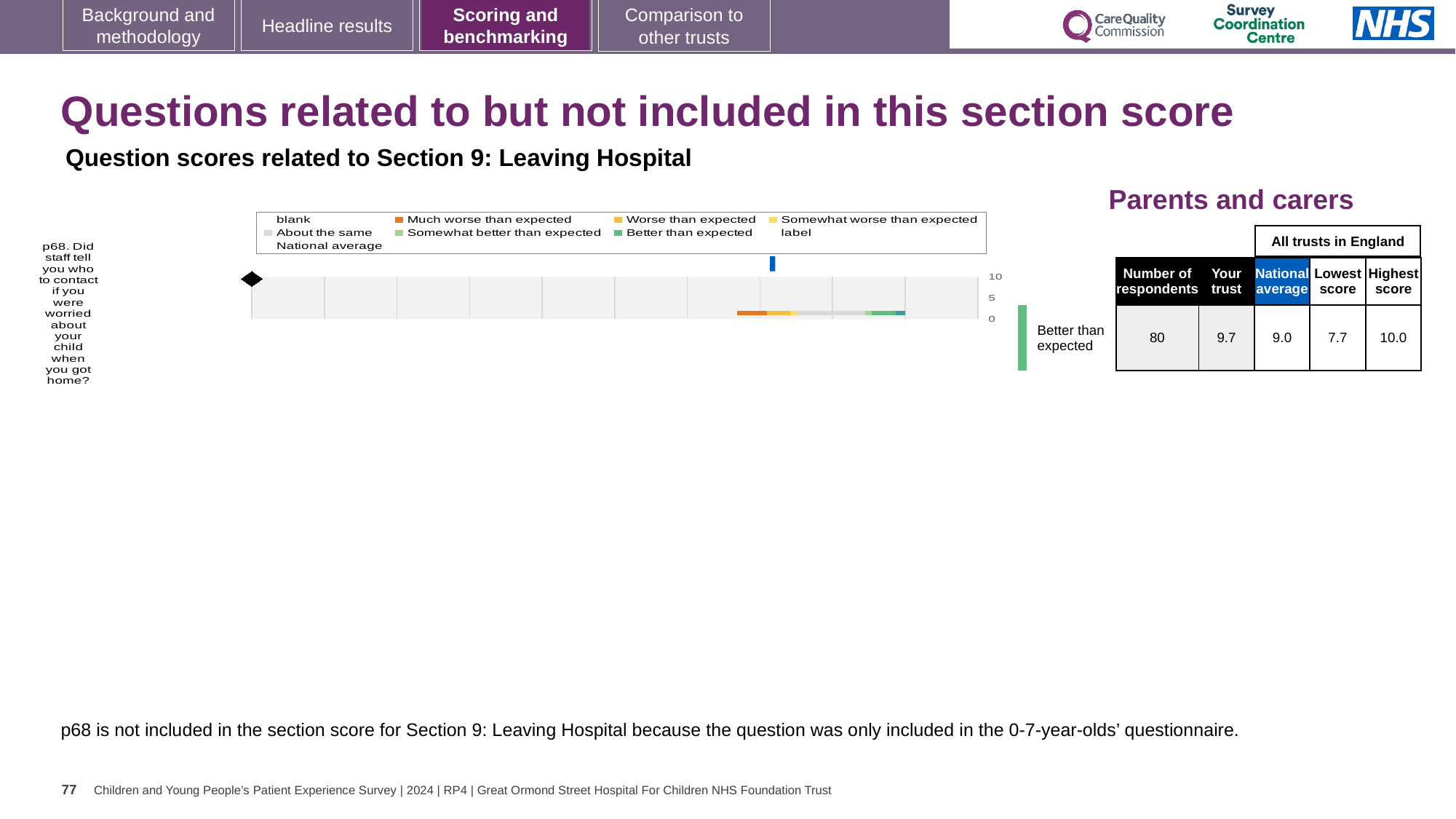
Which question is plotted in the chart? p68. Did staff tell you who to contact if you were worried about your child when you got home? Is the trust's score for p68 higher or lower than the national average? higher According to the table beside the chart, what is the lowest score among all trusts in England for p68? 7.7 According to the table beside the chart, what is the highest score among all trusts in England for p68? 10.0 According to the table beside the chart, how many respondents answered p68? 80 What kind of chart is shown on the slide? bar chart According to the table beside the chart, what is the national average score for p68? 9.0 How many survey questions are plotted in the chart? 1 What rating label is shown next to the chart for question p68? Better than expected According to the table beside the chart, what is the 'Your trust' score for p68? 9.7 What is the highest tick value shown on the chart's axis? 10 What is the difference between the trust's score and the national average for p68? 0.7